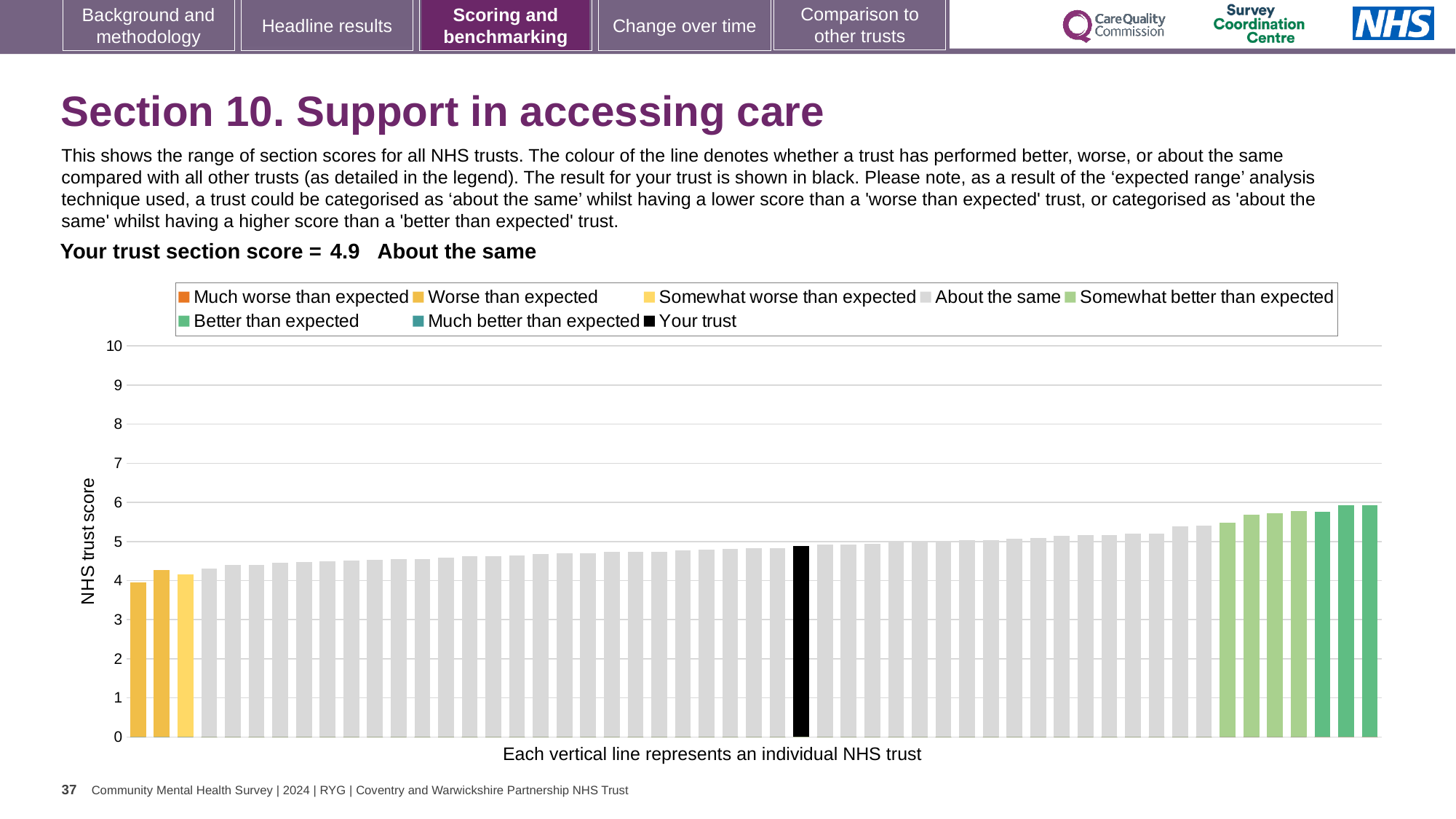
Is the value of the tallest bar greater or less than 5? greater Which legend category do the tallest bars on the chart belong to? Better than expected Which legend category do the shortest bars on the chart belong to? Worse than expected Is the value for your trust greater or less than 5? less Do the bar values rise or fall from left to right along the x axis? rise Which performance category is your trust placed in? About the same How many entries does the chart legend list? 8 What is the section score for your trust shown on the slide? 4.9 What is the label on the vertical axis of the chart? NHS trust score Is the bar for your trust higher or lower than the leftmost bar? higher What kind of chart is shown on the slide? bar chart Is the value of the shortest bar greater or less than 5? less